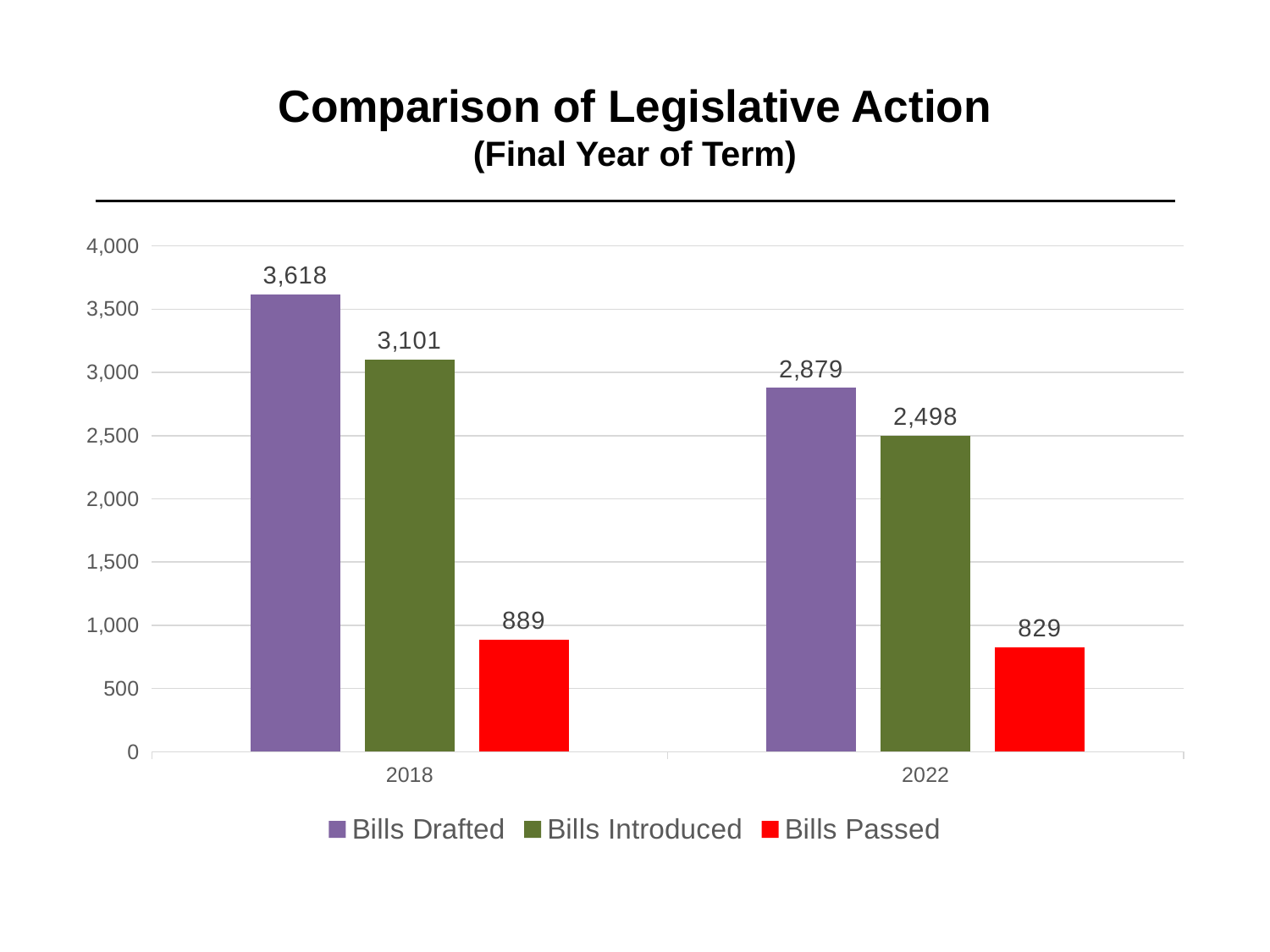
How many Bills Introduced were there in 2022? 2,498 How many Bills Passed were there in 2022? 829 How many Bills Drafted were there in 2018? 3,618 What is the difference between Bills Drafted in 2018 and Bills Drafted in 2022? 739 How many series does the legend list? 3 How many years are shown on the x axis? 2 What kind of chart is shown on the slide? Bar chart Which series has the lowest value in 2022? Bills Passed What is the difference between Bills Introduced and Bills Passed in 2018? 2,212 Do the Bills Introduced values rise or fall from 2018 to 2022? Fall Which series has the highest value in 2018? Bills Drafted Which is larger: Bills Passed in 2018 or Bills Passed in 2022? Bills Passed in 2018